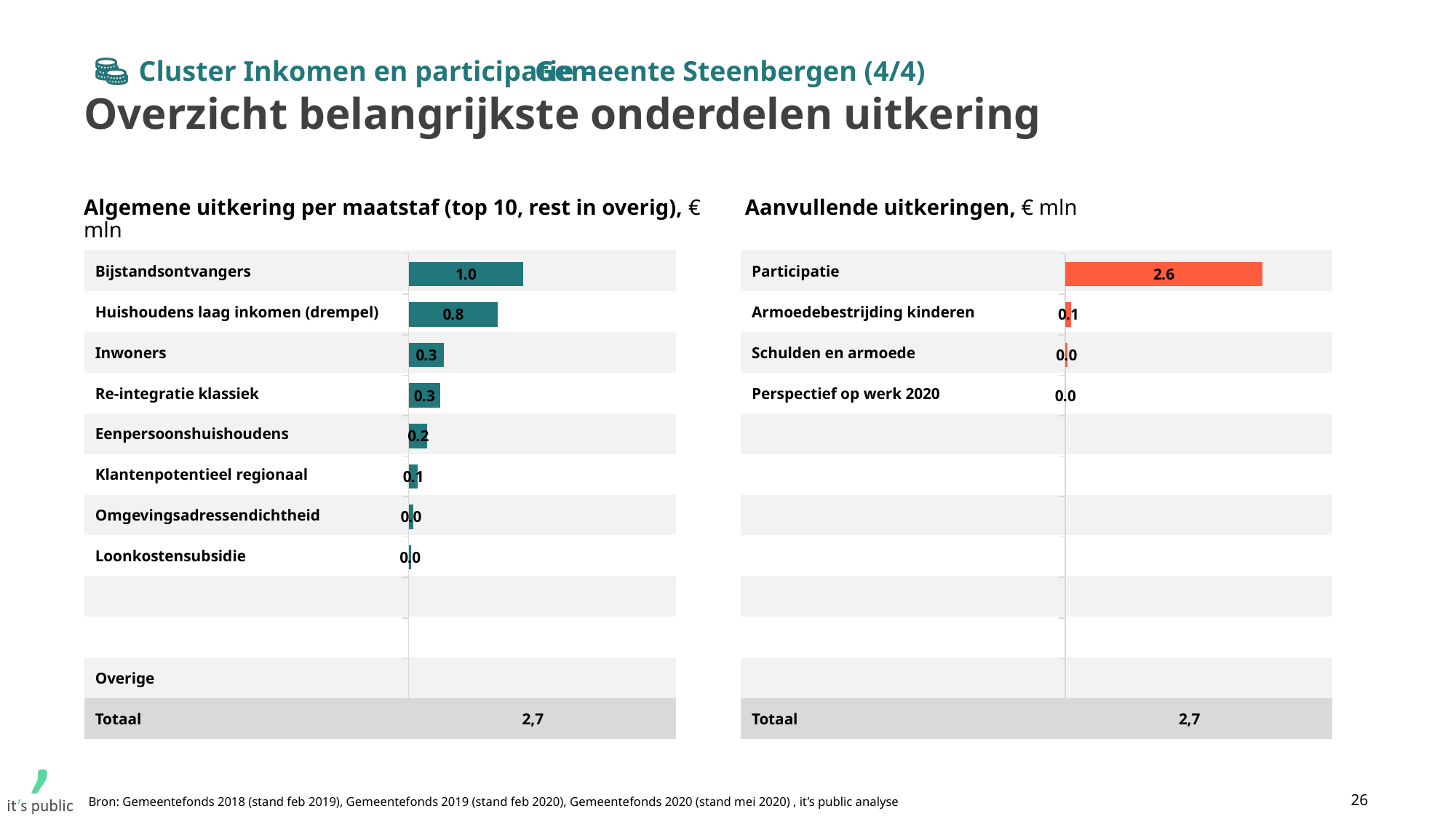
In the 'Aanvullende uitkeringen' chart, what is the value for Armoedebestrijding kinderen? 0.1 In the 'Aanvullende uitkeringen' chart, what is the difference between Participatie and Armoedebestrijding kinderen? 2.5 In the 'Algemene uitkering per maatstaf' chart, what is the value for Huishoudens laag inkomen (drempel)? 0.8 What type of chart is used on the left side of the slide? Bar chart In the 'Algemene uitkering per maatstaf' chart, what is the difference between Bijstandsontvangers and Huishoudens laag inkomen (drempel)? 0.2 In the 'Algemene uitkering per maatstaf' chart, which category has the highest value? Bijstandsontvangers In the 'Algemene uitkering per maatstaf' chart, what is the value for Bijstandsontvangers? 1.0 In the 'Algemene uitkering per maatstaf' chart, what is the Totaal shown at the bottom? 2,7 In the 'Algemene uitkering per maatstaf' chart, what is the value for Klantenpotentieel regionaal? 0.1 In the 'Aanvullende uitkeringen' chart, how many categories have a labeled value? 4 In the 'Aanvullende uitkeringen' chart, what is the value for Participatie? 2.6 In the 'Algemene uitkering per maatstaf' chart, which is larger: Inwoners or Eenpersoonshuishoudens? Inwoners